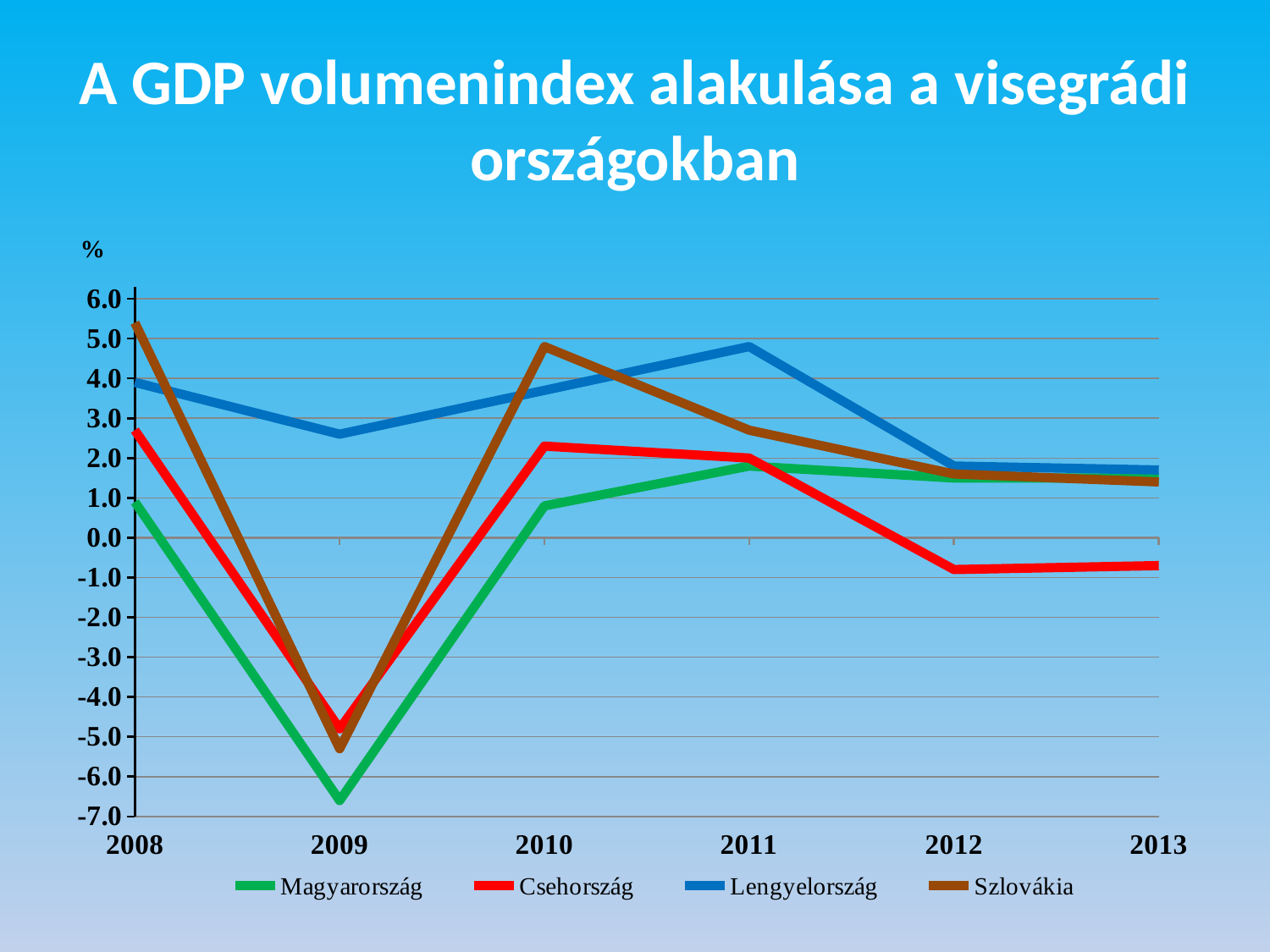
Does the value for Lengyelország rise or fall from 2011 to 2012? fall Which country has the lowest value in 2009? Magyarország Which country has the highest value in 2008? Szlovákia Is the value for Magyarország in 2009 greater or less than -6.0? less How many years are shown on the x axis? 6 Is the value for Csehország in 2012 greater or less than 0.0? less What colour is the line for Csehország? red How many series does the legend list? 4 Which country has the highest value in 2011? Lengyelország In 2012, which is larger: the value for Csehország or the value for Lengyelország? Lengyelország Is the value for Lengyelország in 2011 greater or less than 4.0? greater What kind of chart is shown on the slide? line chart